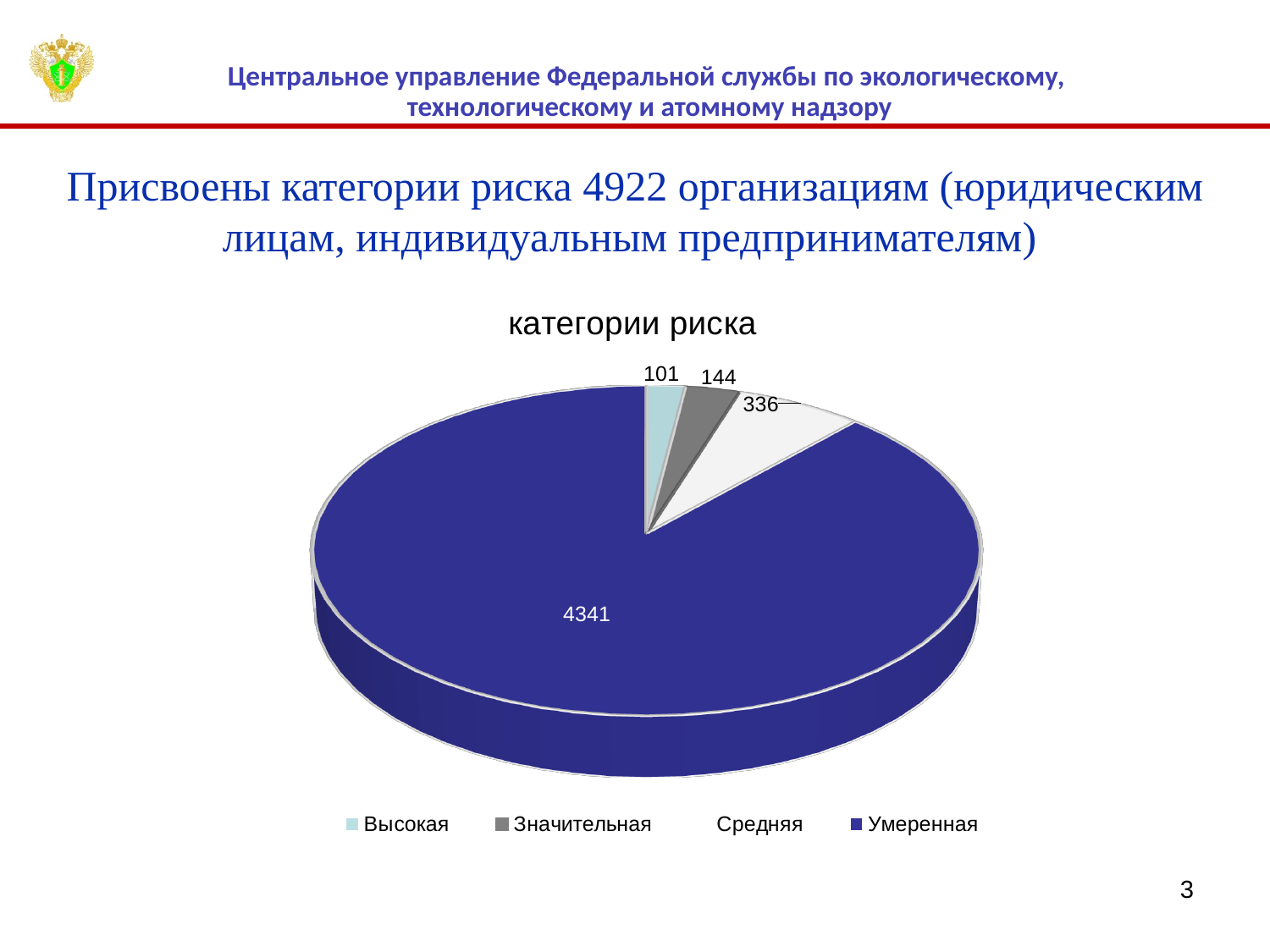
What kind of chart is shown on the slide? pie chart Which is larger, the value for Значительная or the value for Высокая? Значительная How many categories does the legend list? 4 What is the total of all four categories in the pie chart? 4922 Which category has the smallest slice? Высокая Which category has the largest slice? Умеренная What is the value for the Высокая category? 101 What is the difference between the values for Средняя and Значительная? 192 What is the value for the Средняя category? 336 What is the title of the chart? категории риска What is the value for the Значительная category? 144 What is the value for the Умеренная category? 4341